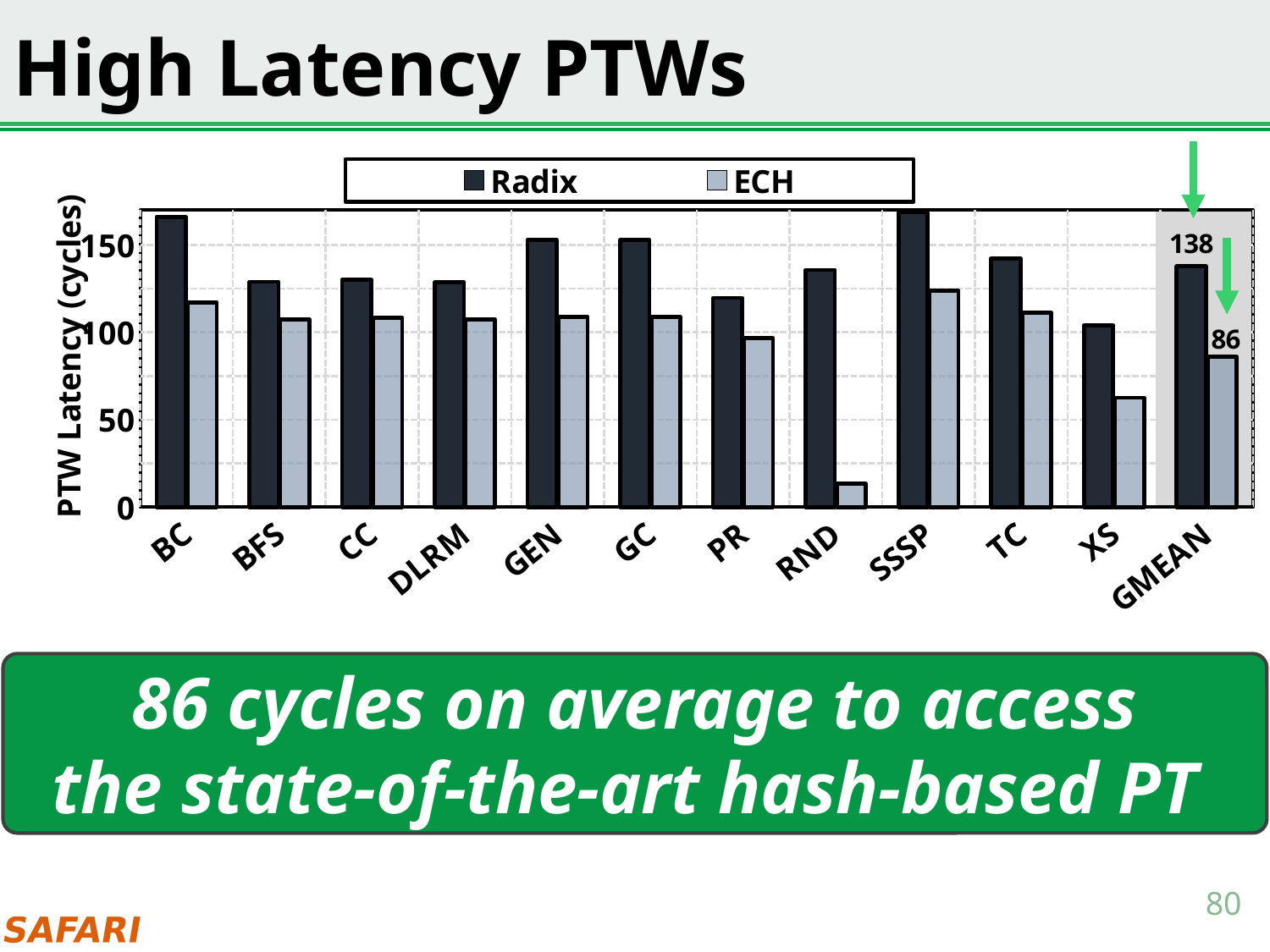
What kind of chart is shown on the slide? Bar chart What is the Radix PTW latency value shown for GMEAN? 138 What is the label of the y axis? PTW Latency (cycles) How many categories are shown on the x axis of the chart? 12 Is the Radix value for PR greater or less than 100? greater What is the difference between the Radix and ECH values for GMEAN? 52 Which category has the lowest ECH value? RND Is the ECH value for RND greater or less than 50? less What is the ECH PTW latency value shown for GMEAN? 86 Is the Radix value for SSSP greater or less than 150? greater How many series does the legend list? 2 Which category has the lowest Radix value? XS